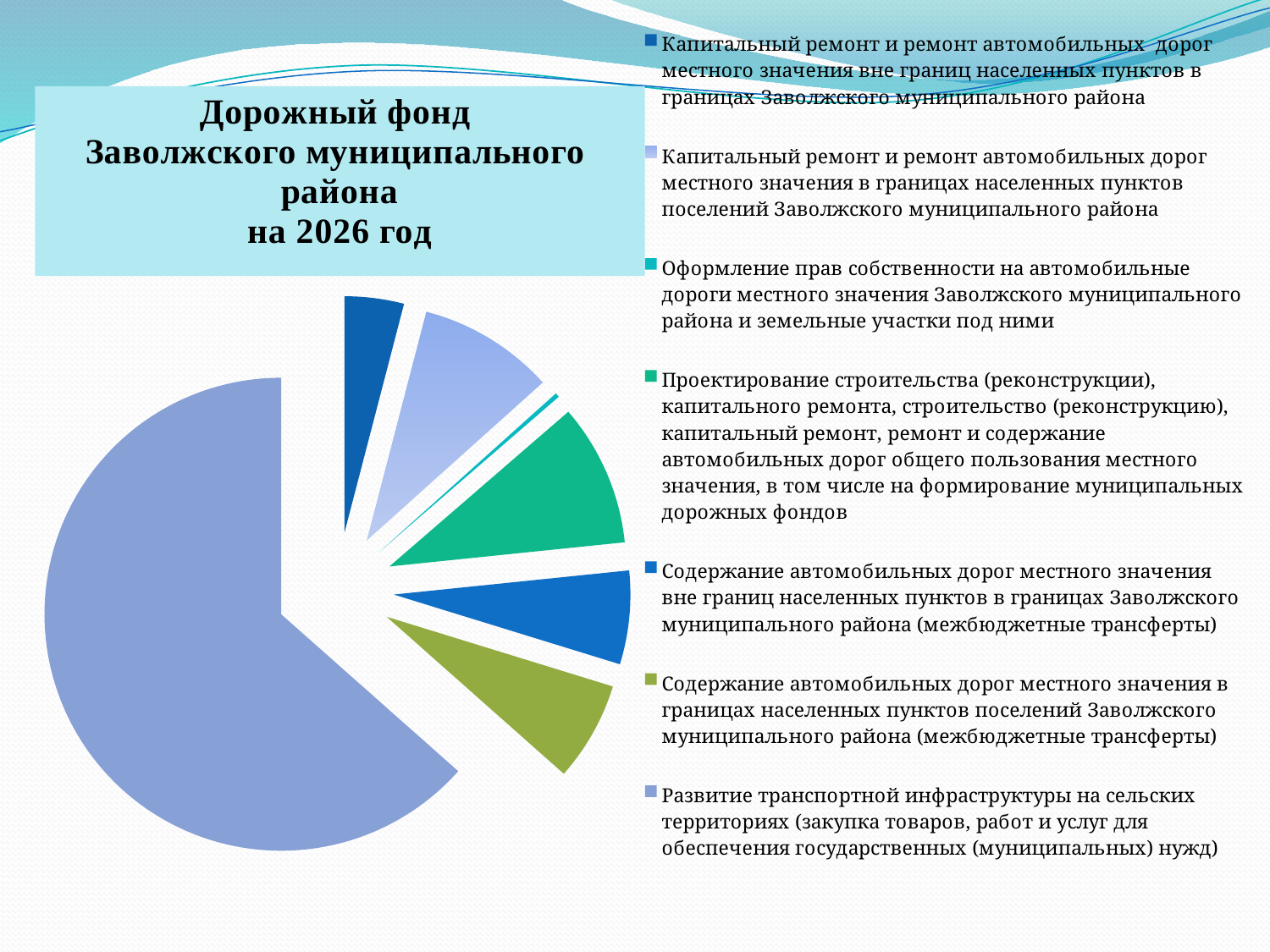
Which slice is larger: 'Развитие транспортной инфраструктуры на сельских территориях...' or 'Содержание автомобильных дорог местного значения вне границ населенных пунктов... (межбюджетные трансферты)'? Развитие транспортной инфраструктуры на сельских территориях... Which category has the smallest slice of the pie chart? Оформление прав собственности на автомобильные дороги местного значения Заволжского муниципального района и земельные участки под ними What colour is the slice for 'Проектирование строительства (реконструкции)...' in the pie chart? green What is the title of the chart on the slide? Дорожный фонд Заволжского муниципального района на 2026 год How many categories does the legend of the pie chart list? 7 What kind of chart is shown on the slide? pie chart Does the largest slice of the pie chart account for more or less than half of the pie? more Which category has the largest slice of the pie chart? Развитие транспортной инфраструктуры на сельских территориях (закупка товаров, работ и услуг для обеспечения государственных (муниципальных) нужд) Which slice is larger: the one for 'Проектирование строительства (реконструкции)...' or the one for 'Капитальный ремонт и ремонт автомобильных дорог местного значения вне границ населенных пунктов...'? Проектирование строительства (реконструкции)...